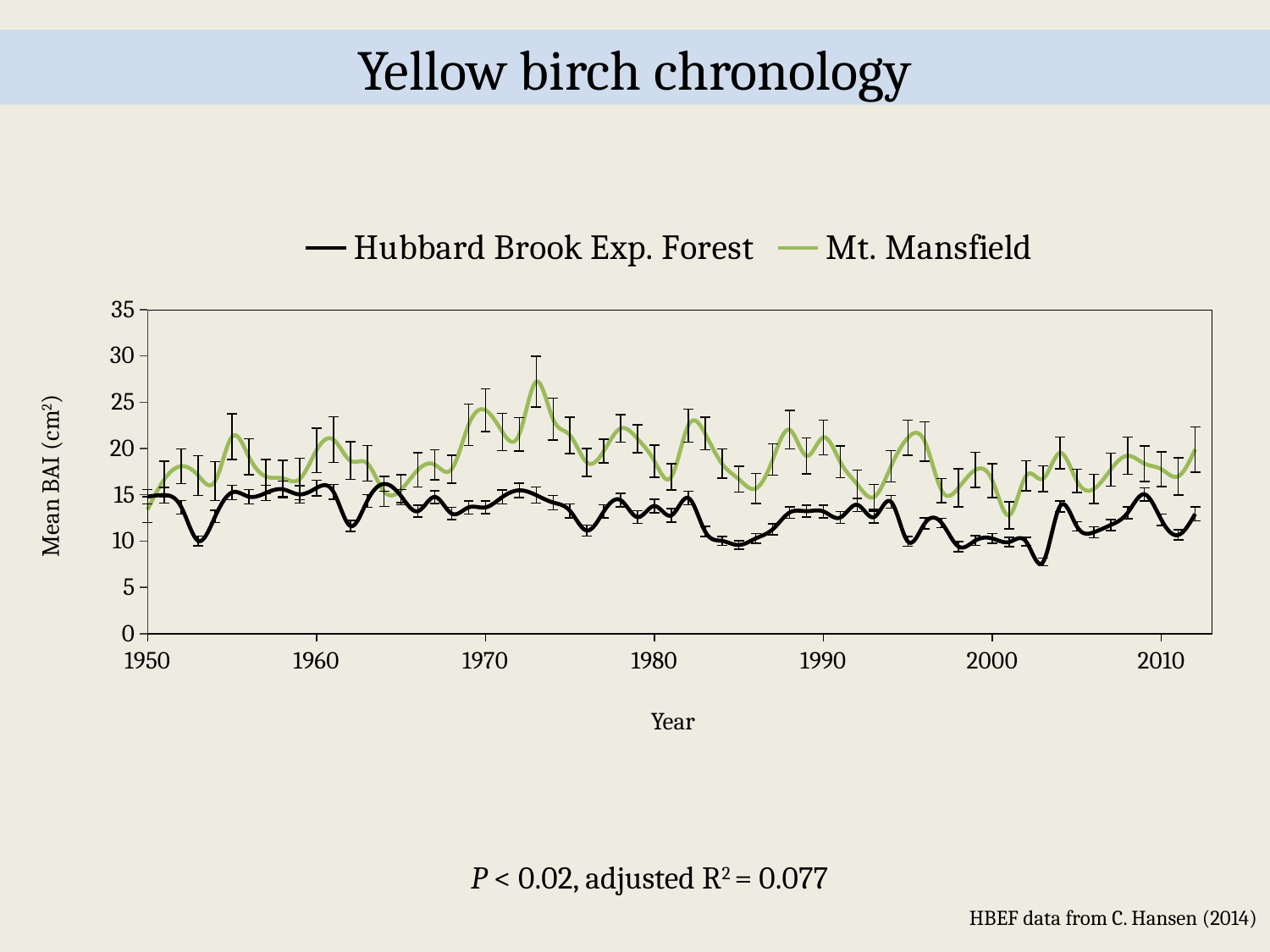
Is the lowest value for Hubbard Brook Exp. Forest (around 2003) greater or less than 10? less Which series reaches the highest value on the chart? Mt. Mansfield What is the title of the chart? Yellow birch chronology How many series does the legend list? 2 Is the peak value for Mt. Mansfield (around 1973) greater or less than 25? greater Around 1990, which series has the larger value, Hubbard Brook Exp. Forest or Mt. Mansfield? Mt. Mansfield Is the value for Mt. Mansfield around 2001 greater or less than 15? less Which series has the lowest value on the chart? Hubbard Brook Exp. Forest What kind of chart is shown on the slide? line chart How many year labels are shown on the x axis? 7 What is the label of the y axis? Mean BAI (cm²) Between which two labeled years on the x axis does the Mt. Mansfield series reach its peak? 1970 and 1980